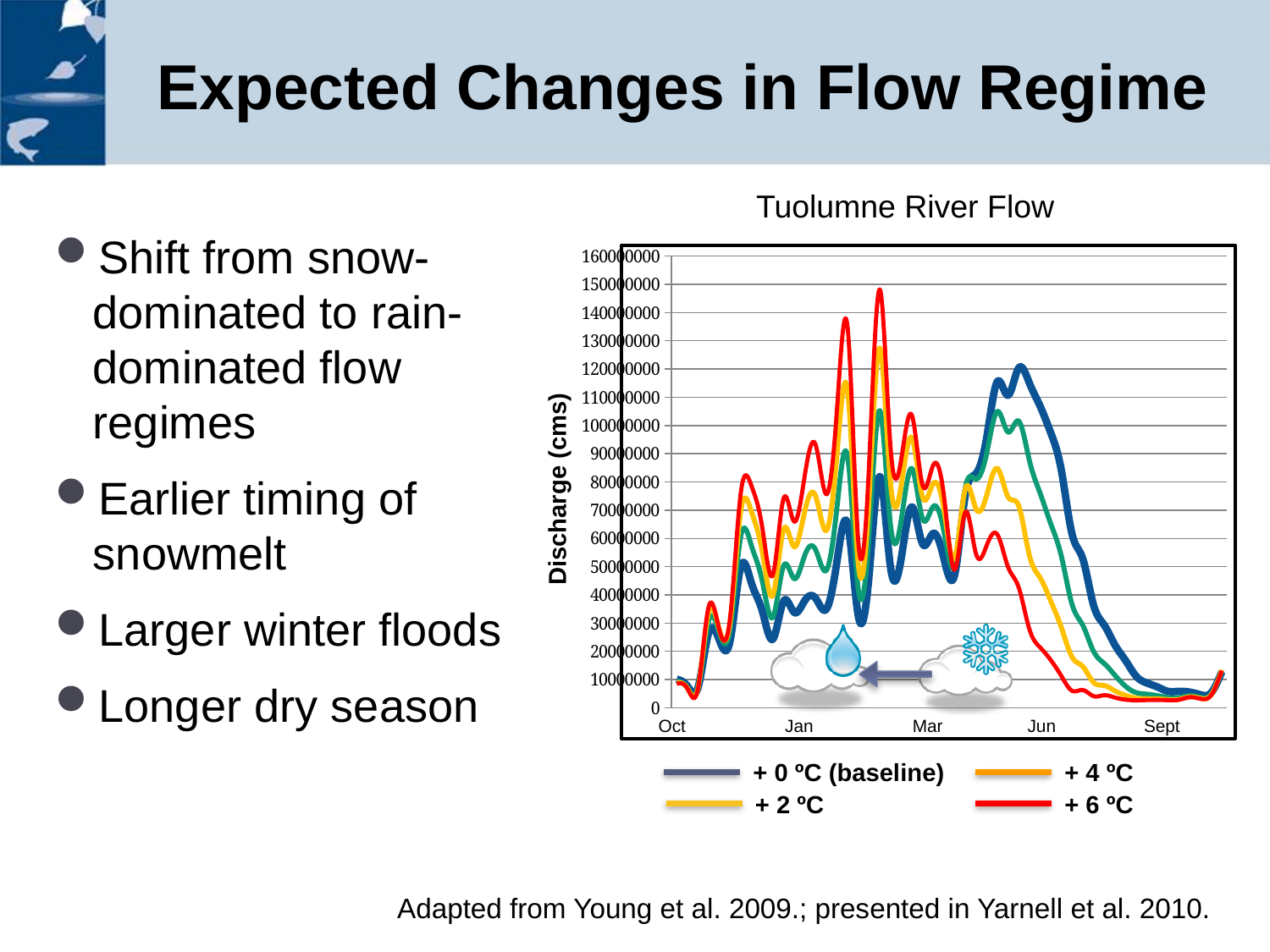
How many month labels are shown along the x axis? 5 Is the discharge of the + 6 ºC series at Sept greater or less than 10000000? less Is the highest peak of the + 0 ºC (baseline) series greater or less than 130000000? less At Jun, which series has the larger discharge: + 0 ºC (baseline) or + 6 ºC? + 0 ºC (baseline) Is the highest peak of the + 6 ºC series greater or less than 140000000? greater What is the label of the y axis? Discharge (cms) How many series does the chart legend list? 4 What is the title of the chart? Tuolumne River Flow Does the + 0 ºC (baseline) series rise or fall between Jun and Sept? fall Which series reaches the highest discharge value on the chart? + 6 ºC What kind of chart is shown on the slide? line chart